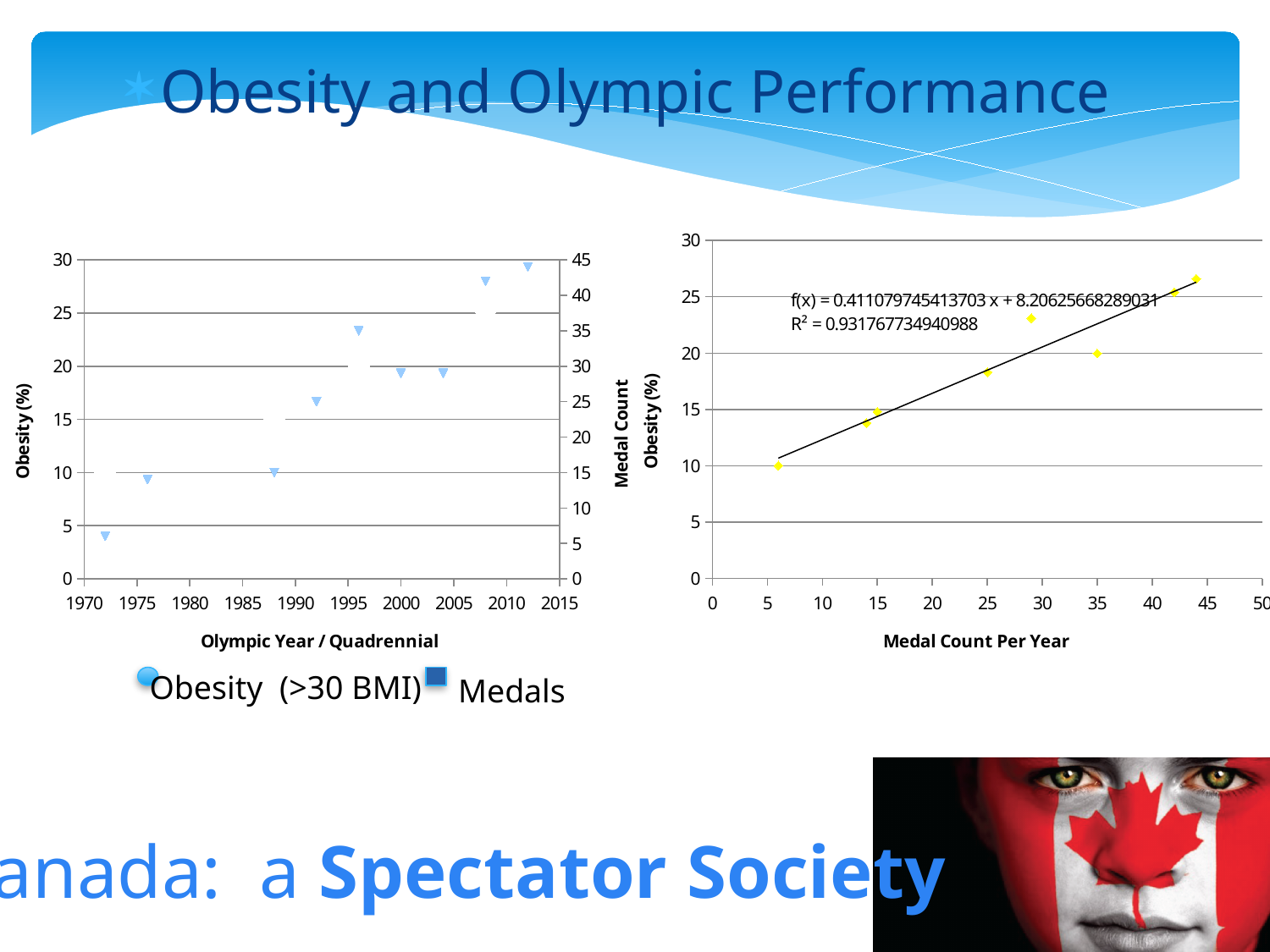
What kind of chart is the left chart (Olympic Year / Quadrennial)? scatter chart In the left chart (Olympic Year / Quadrennial), which year has the lowest obesity value? 1972 In the right chart (Medal Count Per Year), how many data points are plotted? 8 In the right chart (Medal Count Per Year), does obesity rise or fall as medal count increases? rise How many series does the legend of the left chart (Olympic Year / Quadrennial) list? 2 In the left chart (Olympic Year / Quadrennial), is the obesity value for 2012 greater or less than 25? greater In the left chart (Olympic Year / Quadrennial), which year has the highest obesity value? 2012 What R² value is printed on the right chart (Medal Count Per Year)? 0.931767734940988 In the left chart (Olympic Year / Quadrennial), does obesity generally rise or fall from 1972 to 2012? rise